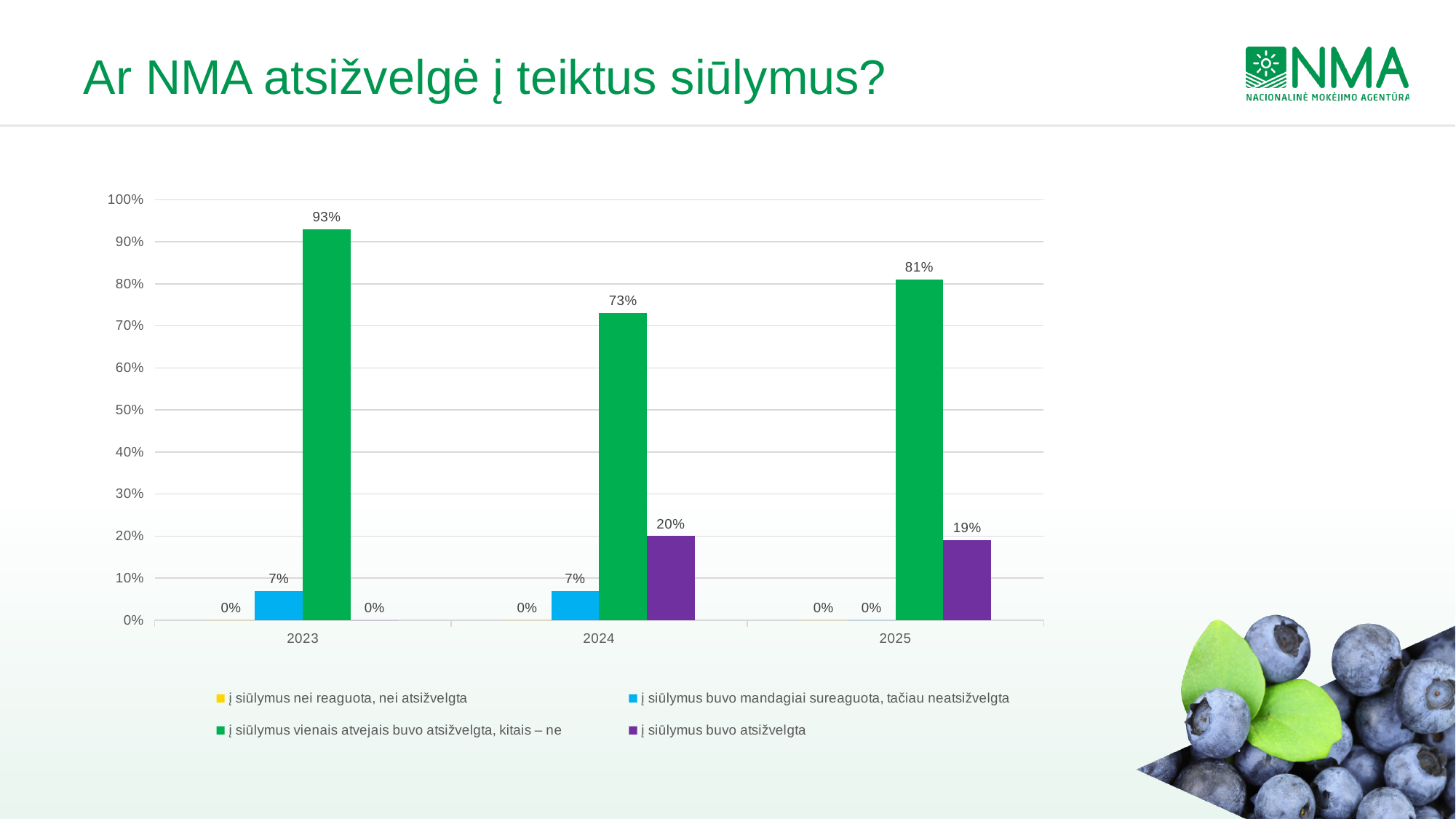
What is the difference between the 2023 and 2025 values for 'į siūlymus vienais atvejais buvo atsižvelgta, kitais – ne'? 12% What kind of chart is shown on the slide? Bar chart In which year is the value for 'į siūlymus vienais atvejais buvo atsižvelgta, kitais – ne' the lowest? 2024 What is the value for 'į siūlymus buvo atsižvelgta' in 2024? 20% What is the value for 'į siūlymus vienais atvejais buvo atsižvelgta, kitais – ne' in 2023? 93% How many years are shown on the x axis? 3 What is the title of the slide? Ar NMA atsižvelgė į teiktus siūlymus? What is the value for 'į siūlymus nei reaguota, nei atsižvelgta' in 2024? 0% In which year is the value for 'į siūlymus vienais atvejais buvo atsižvelgta, kitais – ne' the highest? 2023 Which is larger: the 2024 or the 2025 value for 'į siūlymus buvo atsižvelgta'? 2024 What is the value for 'į siūlymus buvo mandagiai sureaguota, tačiau neatsižvelgta' in 2025? 0% How many series does the legend list? 4